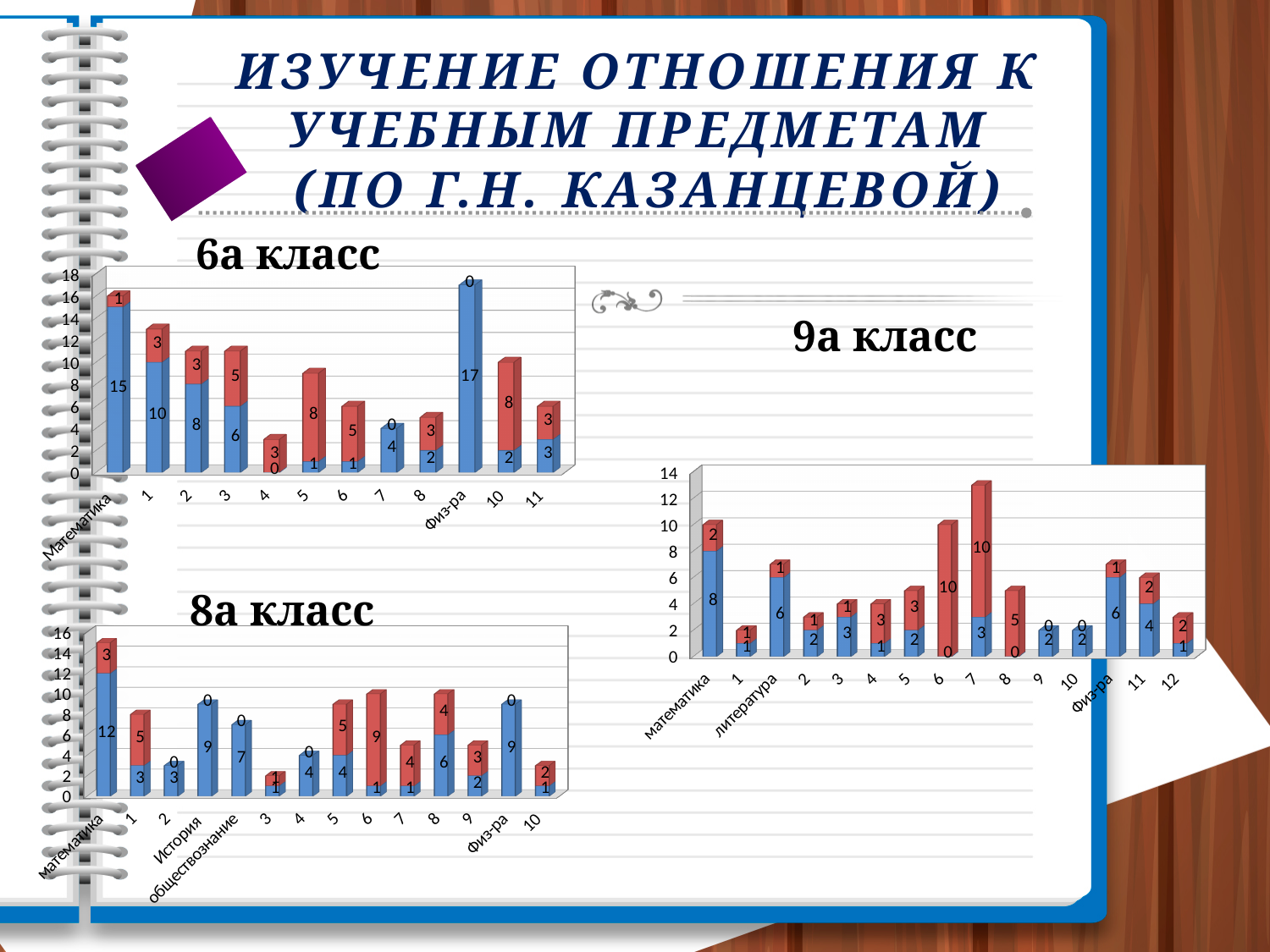
In the 9а класс chart, which category has the tallest stacked bar? 7 How many categories are shown on the x axis of the 9а класс chart? 15 In the 9а класс chart, what is the total of the stacked bar for математика? 10 In the 8а класс chart, what is the value of the blue segment for Математика? 12 In the 6а класс chart, what is the value of the red segment for category 5? 8 In the 6а класс chart, what is the value of the blue segment for Математика? 15 In the 6а класс chart, what is the total height of the stacked bar for Физ-ра? 17 In the 8а класс chart, what is the value of the blue segment for История? 9 In the 8а класс chart, what is the total of the stacked bar for category 8? 10 In the 6а класс chart, which category has the tallest stacked bar? Физ-ра In the 9а класс chart, what is the value of the red segment for category 7? 10 What type of chart is used for 8а класс? Stacked bar chart